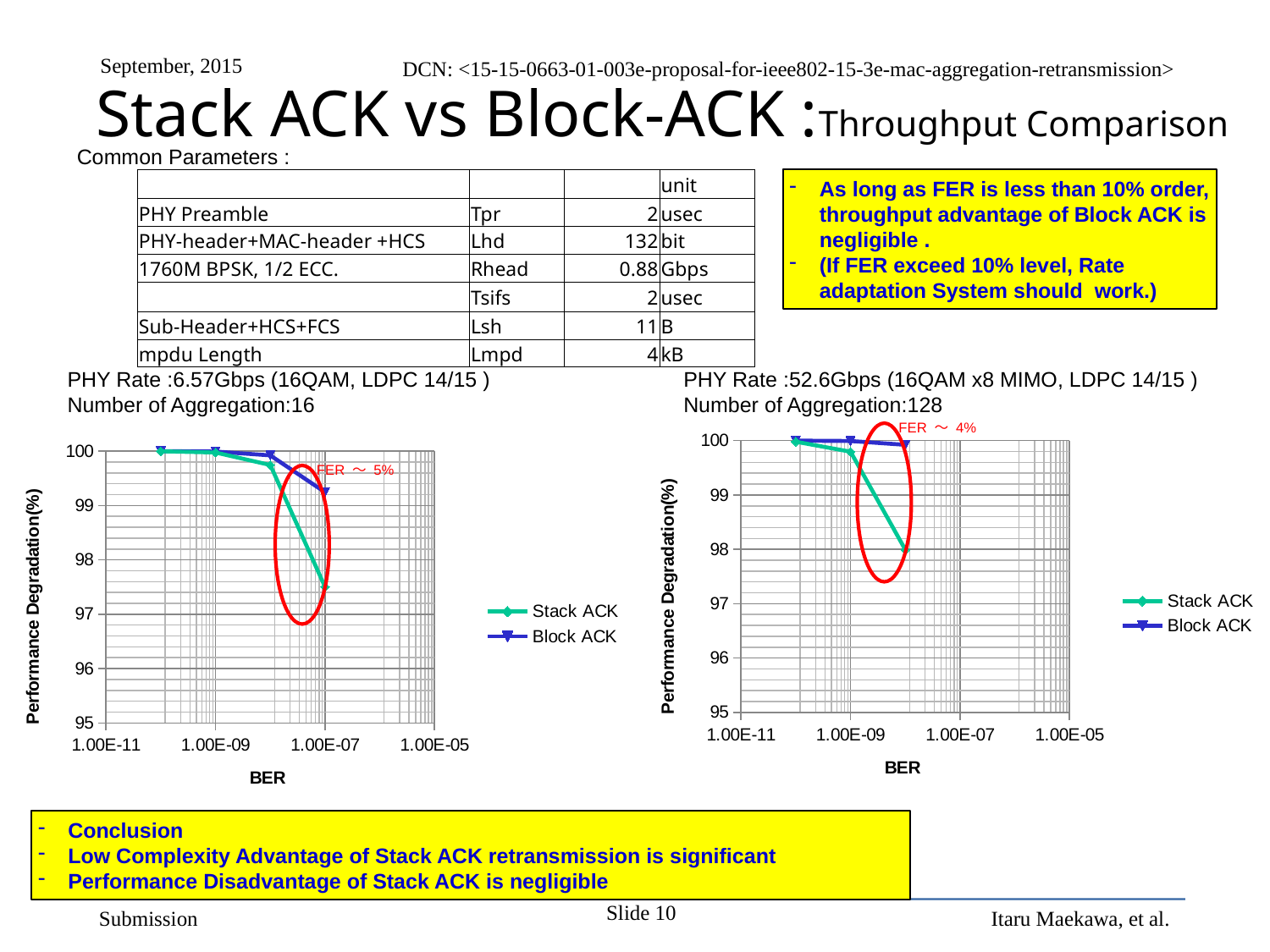
How many series does the legend of the left chart (Number of Aggregation 16) list? 2 What kind of chart is the left chart (PHY Rate 6.57Gbps, Number of Aggregation 16)? line chart In the left chart (Number of Aggregation 16), is the Block ACK value at BER 1.00E-07 greater or less than 99? greater What are the two series named in the legend of the right chart (Number of Aggregation 128)? Stack ACK and Block ACK In the left chart (Number of Aggregation 16), is the Stack ACK value at BER 1.00E-07 greater or less than 98? less How many data points does the Stack ACK series have in the left chart (Number of Aggregation 16)? 4 In the left chart (Number of Aggregation 16), does the Stack ACK series rise or fall as BER increases along the x axis? fall What is the x-axis title of the right chart (Number of Aggregation 128)? BER In the left chart (Number of Aggregation 16), which series has the higher value at BER 1.00E-07, Stack ACK or Block ACK? Block ACK In the right chart (Number of Aggregation 128), is the Block ACK value at BER 1.00E-08 greater or less than 99? greater